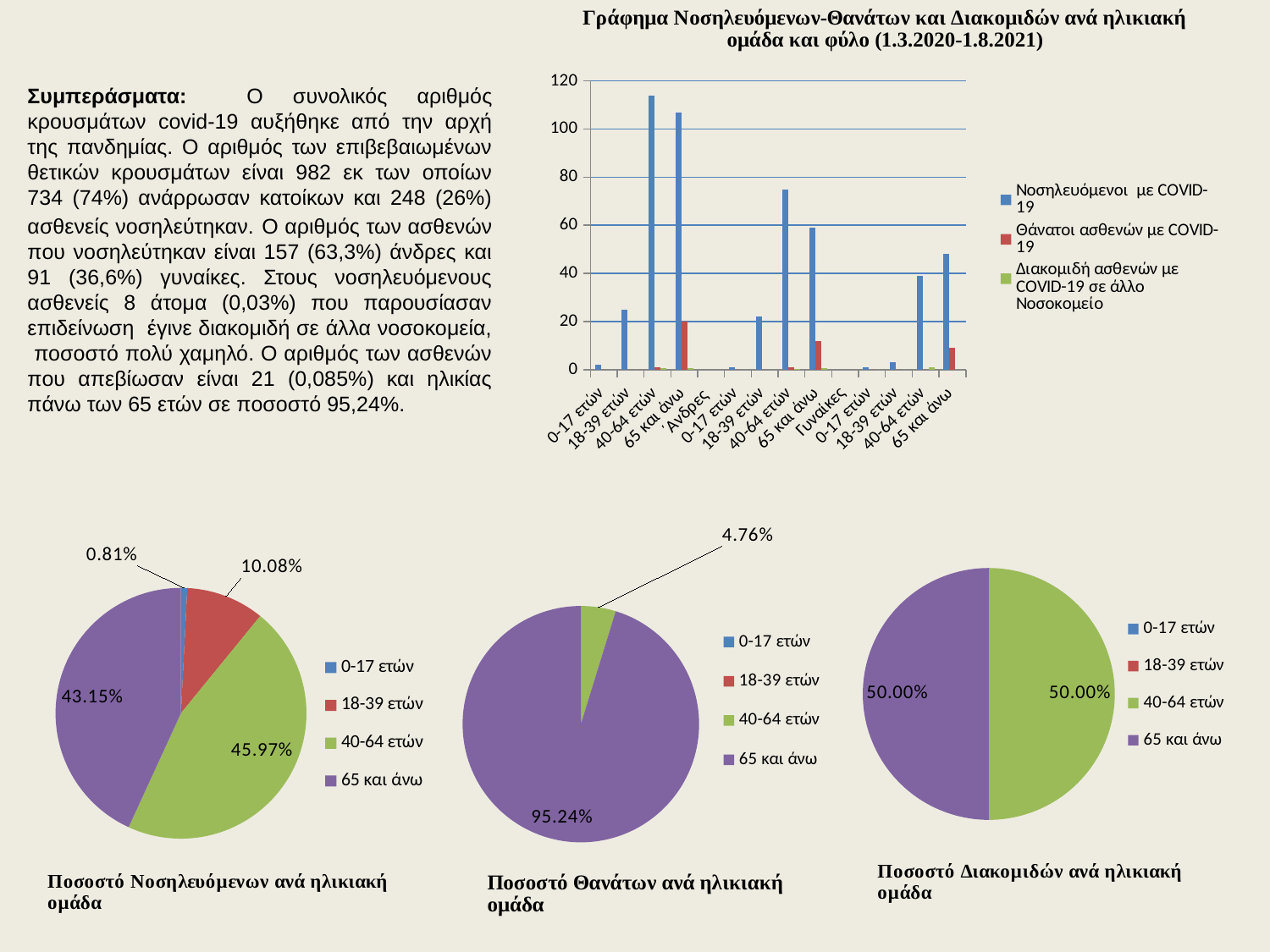
In the pie chart 'Ποσοστό Διακομιδών ανά ηλικιακή ομάδα', what share does the 65 και άνω slice have? 50.00% How many series does the legend of the bar chart at the top right list? 3 In the pie chart 'Ποσοστό Νοσηλευόμενων ανά ηλικιακή ομάδα', what is the value for 18-39 ετών? 10.08% In the pie chart 'Ποσοστό Θανάτων ανά ηλικιακή ομάδα', what is the value for 40-64 ετών? 4.76% In the bar chart at the top right, is the value of the 'Νοσηλευόμενοι με COVID-19' bar for the leftmost '40-64 ετών' category greater or less than 100? greater In the bar chart at the top right, which series is shown in red in the legend? Θάνατοι ασθενών με COVID-19 In the pie chart 'Ποσοστό Νοσηλευόμενων ανά ηλικιακή ομάδα', what is the difference between the 40-64 ετών and 65 και άνω shares? 2.82% What kind of chart is the chart titled 'Γράφημα Νοσηλευόμενων-Θανάτων και Διακομιδών ανά ηλικιακή ομάδα και φύλο (1.3.2020-1.8.2021)'? bar chart In the pie chart 'Ποσοστό Διακομιδών ανά ηλικιακή ομάδα', how many entries does the legend list? 4 In the pie chart 'Ποσοστό Νοσηλευόμενων ανά ηλικιακή ομάδα', what share does the 40-64 ετών slice have? 45.97% In the pie chart 'Ποσοστό Θανάτων ανά ηλικιακή ομάδα', what share does the 65 και άνω slice have? 95.24% In the pie chart 'Ποσοστό Νοσηλευόμενων ανά ηλικιακή ομάδα', which age group has the smallest share? 0-17 ετών